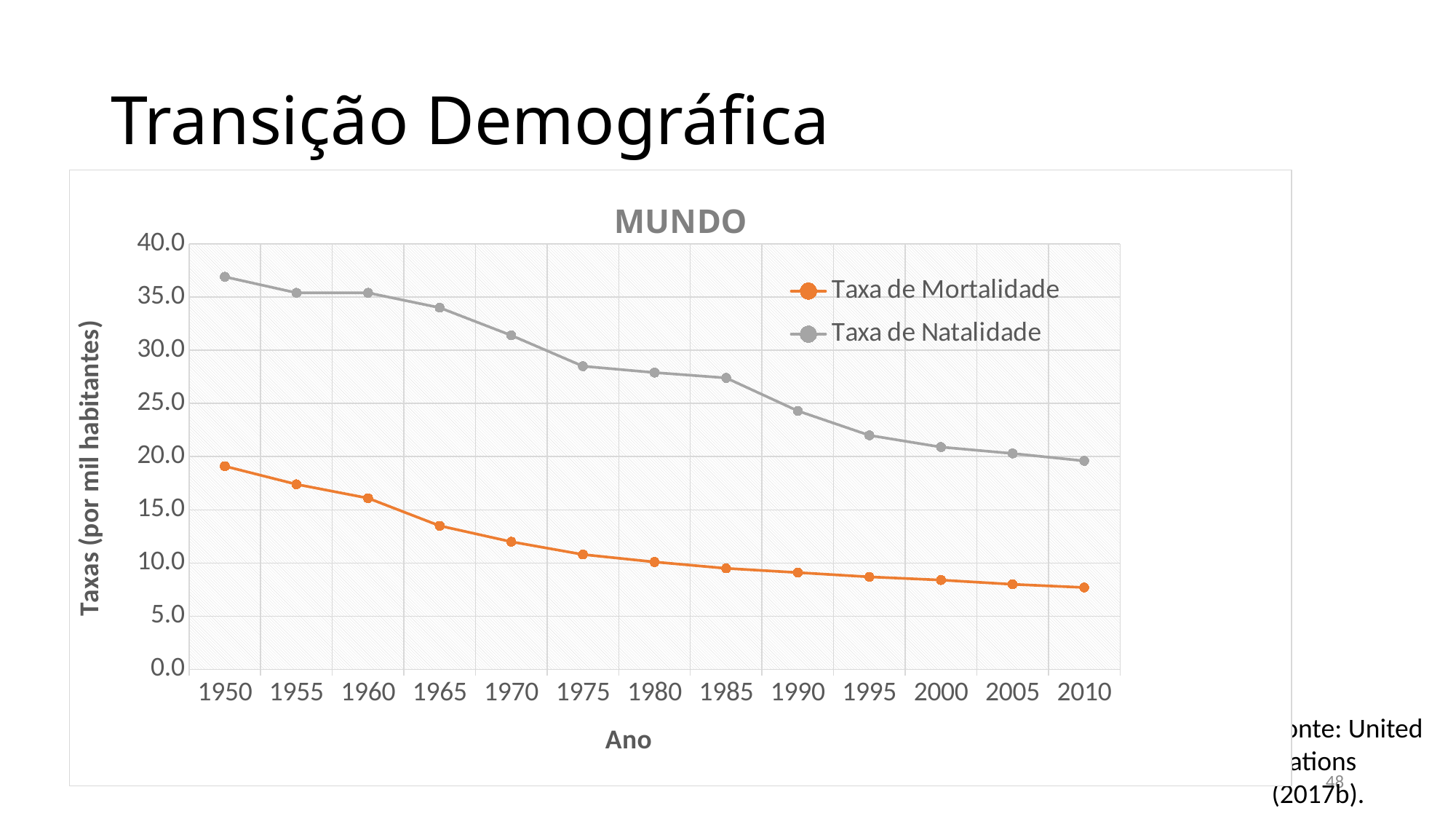
What kind of chart is shown on the slide? line chart How many years are plotted along the x axis? 13 In which year is the Taxa de Mortalidade highest? 1950 Is the Taxa de Natalidade in 1950 greater or less than 35.0? greater Is the Taxa de Natalidade in 2010 greater or less than 25.0? less Does the Taxa de Mortalidade rise or fall from 1950 to 2010? fall Does the Taxa de Natalidade rise or fall from 1950 to 2010? fall In which year is the Taxa de Natalidade lowest? 2010 Is the Taxa de Mortalidade in 1970 greater or less than 15.0? less In 1950, which is larger: Taxa de Natalidade or Taxa de Mortalidade? Taxa de Natalidade How many series does the legend list? 2